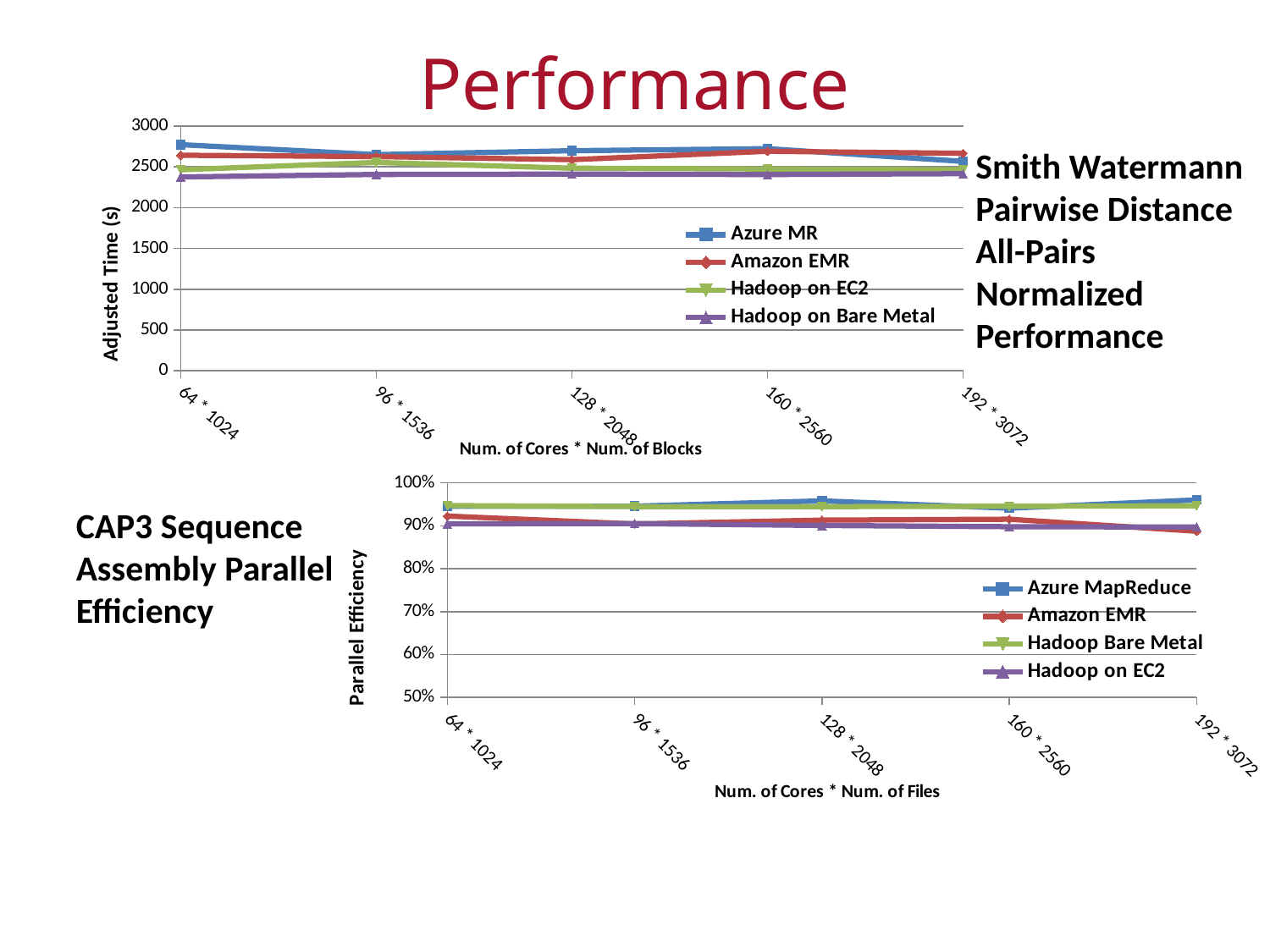
In the bottom chart, which is larger at 192 * 3072: Azure MapReduce or Amazon EMR? Azure MapReduce In the top chart, which series has the highest value at 64 * 1024? Azure MR In the bottom chart, is the Azure MapReduce value at 192 * 3072 greater or less than 90%? greater In the bottom chart, how many categories are shown on the x axis? 5 In the top chart, how many series does the legend list? 4 What kind of chart is the bottom chart (Parallel Efficiency vs Num. of Cores * Num. of Files)? line chart What kind of chart is the top chart (Adjusted Time vs Num. of Cores * Num. of Blocks)? line chart In the top chart, which series has the lowest value at 64 * 1024? Hadoop on Bare Metal What is the y-axis label of the bottom chart? Parallel Efficiency In the bottom chart, does the Amazon EMR line rise or fall from 64 * 1024 to 192 * 3072? fall In the top chart, is the Azure MR value at 64 * 1024 greater or less than 2500? greater In the top chart, is the Hadoop on Bare Metal value at 64 * 1024 greater or less than 2500? less